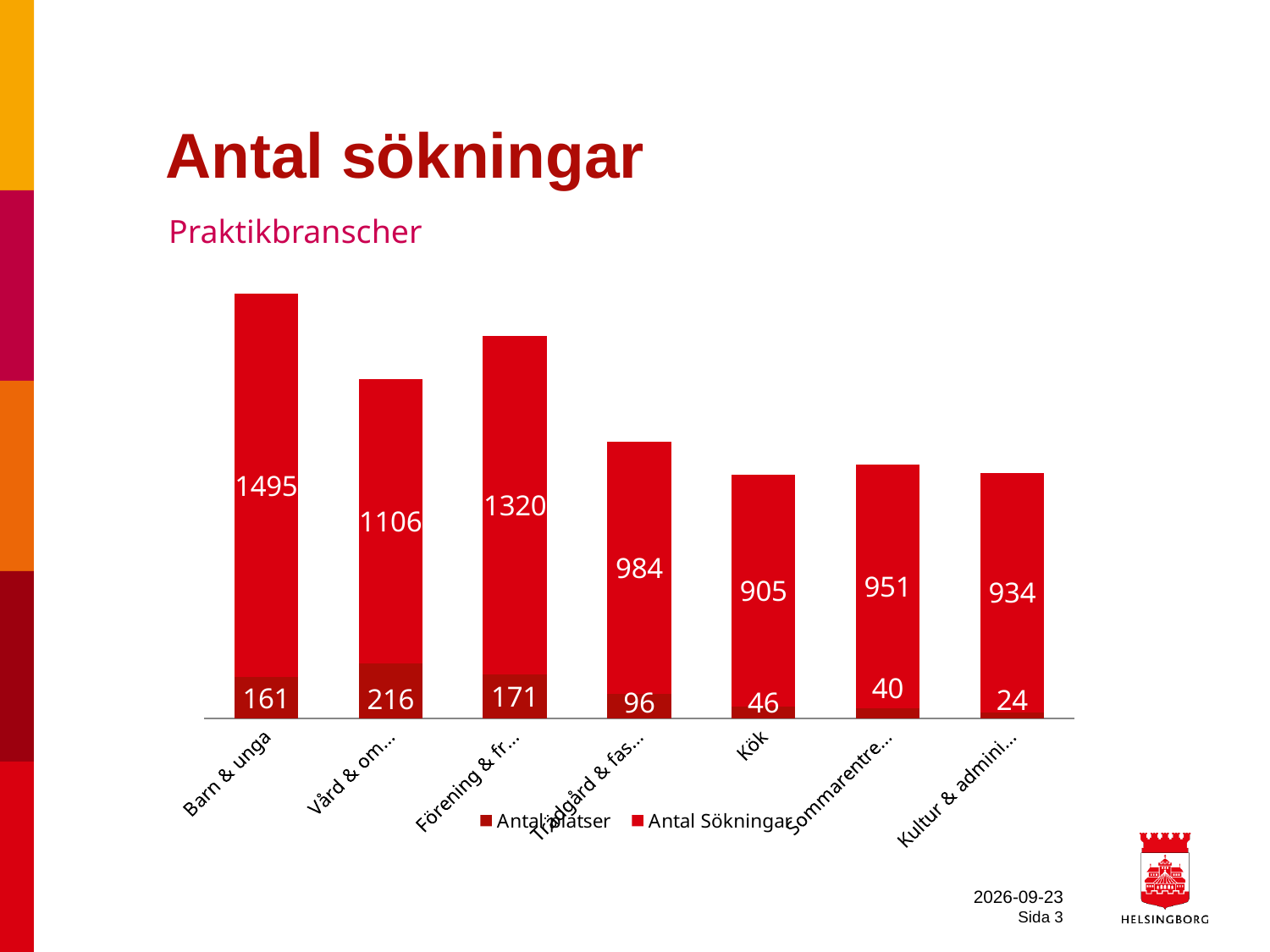
What is the value of Antal Sökningar for Barn & unga? 1495 What is the difference between the Antal Sökningar values for Barn & unga and Kök? 590 What is the value of Antal Sökningar for Kök? 905 What is the value of Antal platser for Barn & unga? 161 What kind of chart is shown on the slide? Stacked bar chart What is the total of the stacked bar for Barn & unga? 1656 Which category has the highest value for Antal Sökningar? Barn & unga What is the value of Antal platser for Kök? 46 How many series does the legend list? 2 How many categories are shown on the x axis? 7 Which category has the lowest value for Antal Sökningar? Kök Which has the larger Antal platser value, Barn & unga or Kök? Barn & unga